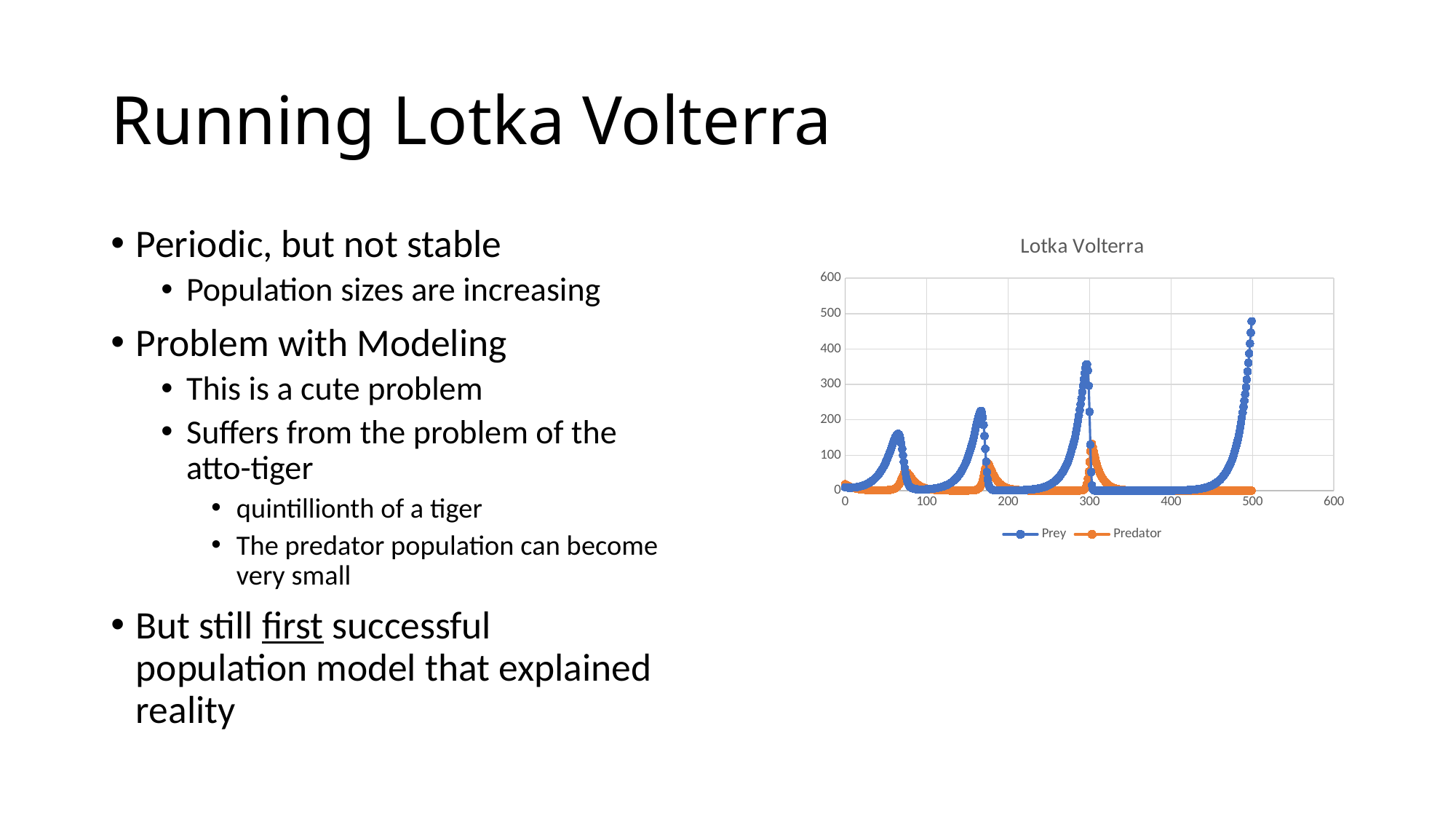
What is the title of the chart? Lotka Volterra Do the successive peaks of the Predator series rise or fall as the x axis increases? rise Which series has the lower peak values overall? Predator Do the successive peaks of the Prey series rise or fall as the x axis increases? rise What are the names of the two series in the legend? Prey and Predator Is the highest value reached by the Predator series greater or less than 200? less Is the first peak of the Prey series greater or less than 200? less What type of chart is shown on the slide? line chart Is the highest value reached by the Prey series greater or less than 500? less Which series reaches the higher peak values, Prey or Predator? Prey How many series does the chart legend list? 2